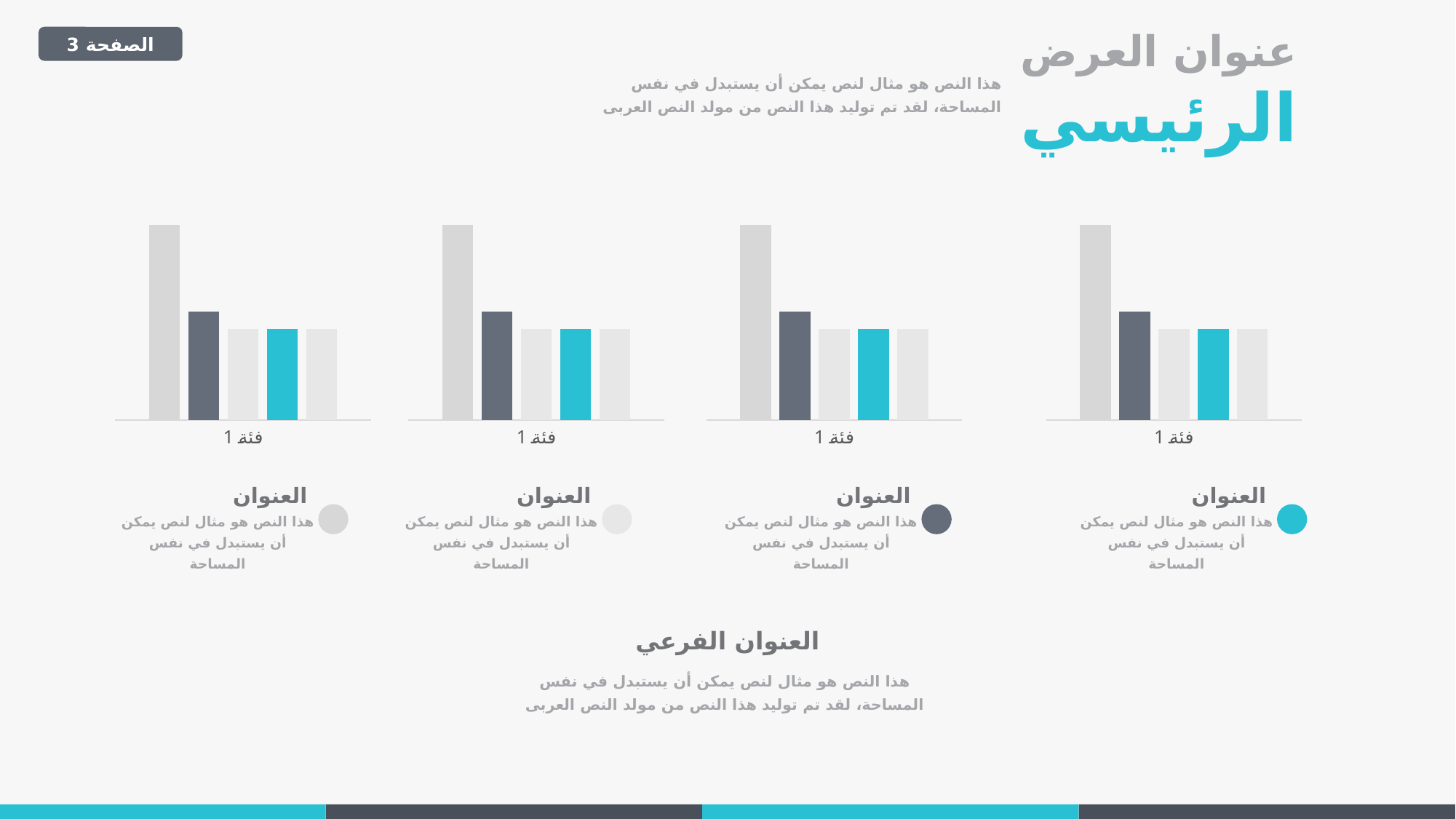
In the third chart from the left, how many bars are plotted? 5 In the second chart from the left, is the dark gray bar taller or shorter than the teal bar? taller What is the category label on the x axis of the rightmost chart? فئة 1 How many charts are shown on the slide? 4 In the leftmost chart, how many categories are labelled on the x axis? 1 What kind of chart is the rightmost chart on the slide? bar chart In the leftmost chart, which bar is the tallest? the first (leftmost) bar What kind of chart is the leftmost chart on the slide? bar chart In the third chart from the left, is the second bar taller or shorter than the third bar? taller In the rightmost chart, is the teal bar taller or shorter than the first (leftmost) bar? shorter In the leftmost chart, how many bars are plotted? 5